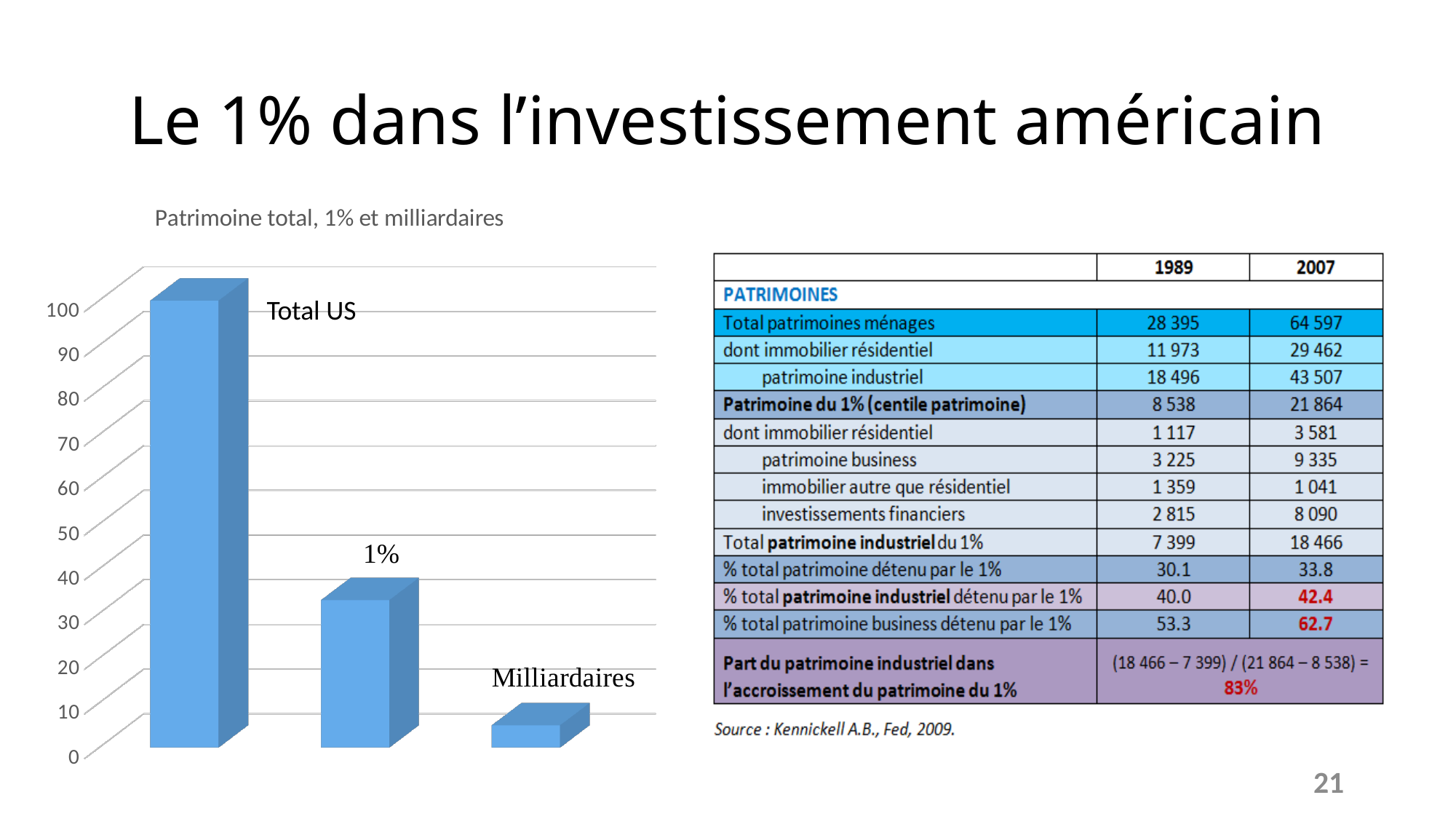
In the chart 'Patrimoine total, 1% et milliardaires', is the value for 1% greater or less than 50? less In the chart 'Patrimoine total, 1% et milliardaires', is the value for Milliardaires greater or less than 10? less In the chart 'Patrimoine total, 1% et milliardaires', is the value for Total US greater or less than 90? greater In the chart 'Patrimoine total, 1% et milliardaires', which category has the lowest value? Milliardaires What kind of chart is shown on the left of the slide? bar chart In the chart 'Patrimoine total, 1% et milliardaires', do the bar values rise or fall from left to right? fall In the chart 'Patrimoine total, 1% et milliardaires', which is larger: the value for 1% or the value for Milliardaires? 1% What is the title of the chart on the left of the slide? Patrimoine total, 1% et milliardaires How many bars does the chart 'Patrimoine total, 1% et milliardaires' show? 3 What colour are the bars in the chart 'Patrimoine total, 1% et milliardaires'? blue In the chart 'Patrimoine total, 1% et milliardaires', which category has the highest value? Total US